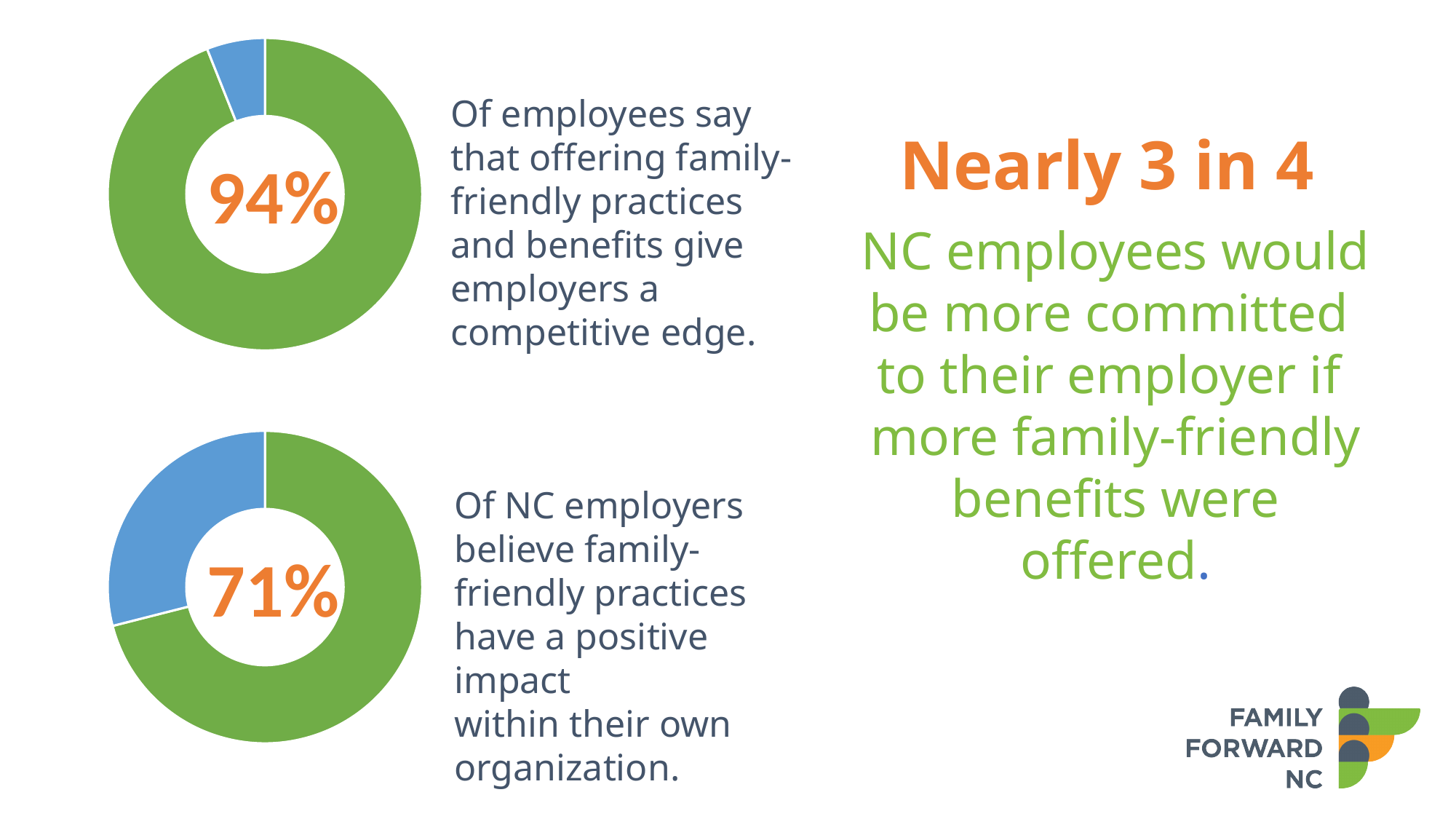
In the bottom donut chart, what percentage is shown in the centre? 71% What colour is the larger slice in the top donut chart? Green What share of the bottom donut chart does the green slice represent? 71% Which chart shows the larger green share, the top donut chart or the bottom donut chart? The top donut chart What kind of chart is the bottom chart on the slide? Donut (pie) chart In the top donut chart, what percentage is shown in the centre? 94% What share of the top donut chart does the green slice represent? 94% How many slices does the bottom donut chart have? 2 What is the difference between the percentage in the top donut chart and the percentage in the bottom donut chart? 23 percentage points In the bottom donut chart, is the blue slice greater or less than 50% of the chart? less How many slices does the top donut chart have? 2 What kind of chart is the top chart on the slide? Donut (pie) chart